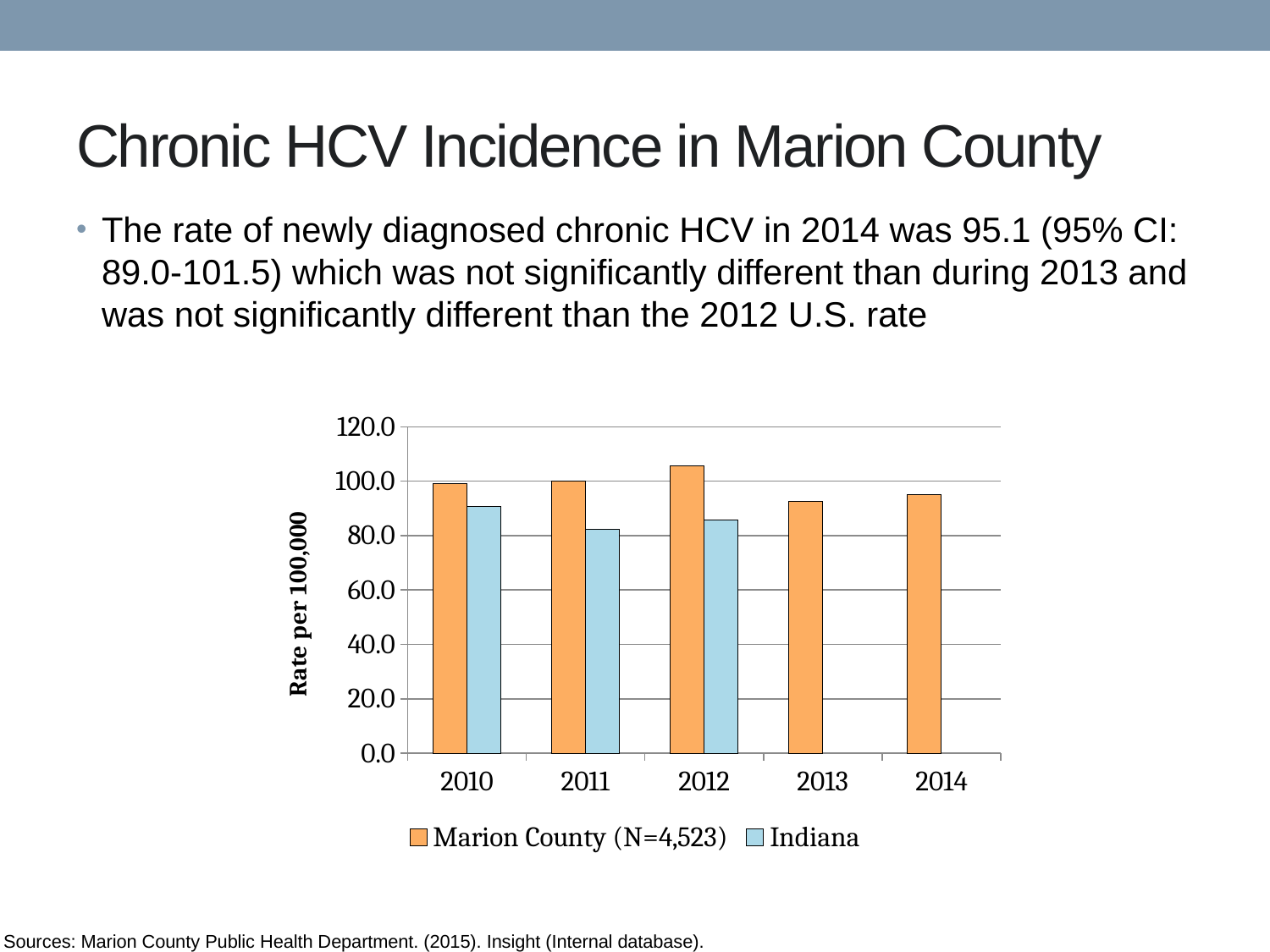
In 2012, which is larger: the Marion County rate or the Indiana rate? Marion County Is the Marion County rate for 2012 greater or less than 100.0? greater In which year is the Indiana rate lowest? 2011 In 2010, which is larger: the Marion County rate or the Indiana rate? Marion County How many years are shown on the x axis of the chart? 5 Is the Marion County rate for 2013 greater or less than 100.0? less In which year is the Marion County rate highest? 2012 For how many years does the chart show an Indiana bar? 3 Is the Indiana rate for 2011 greater or less than 100.0? less What is the label on the vertical axis of the chart? Rate per 100,000 How many series does the chart legend list? 2 What kind of chart is shown on the slide? bar chart